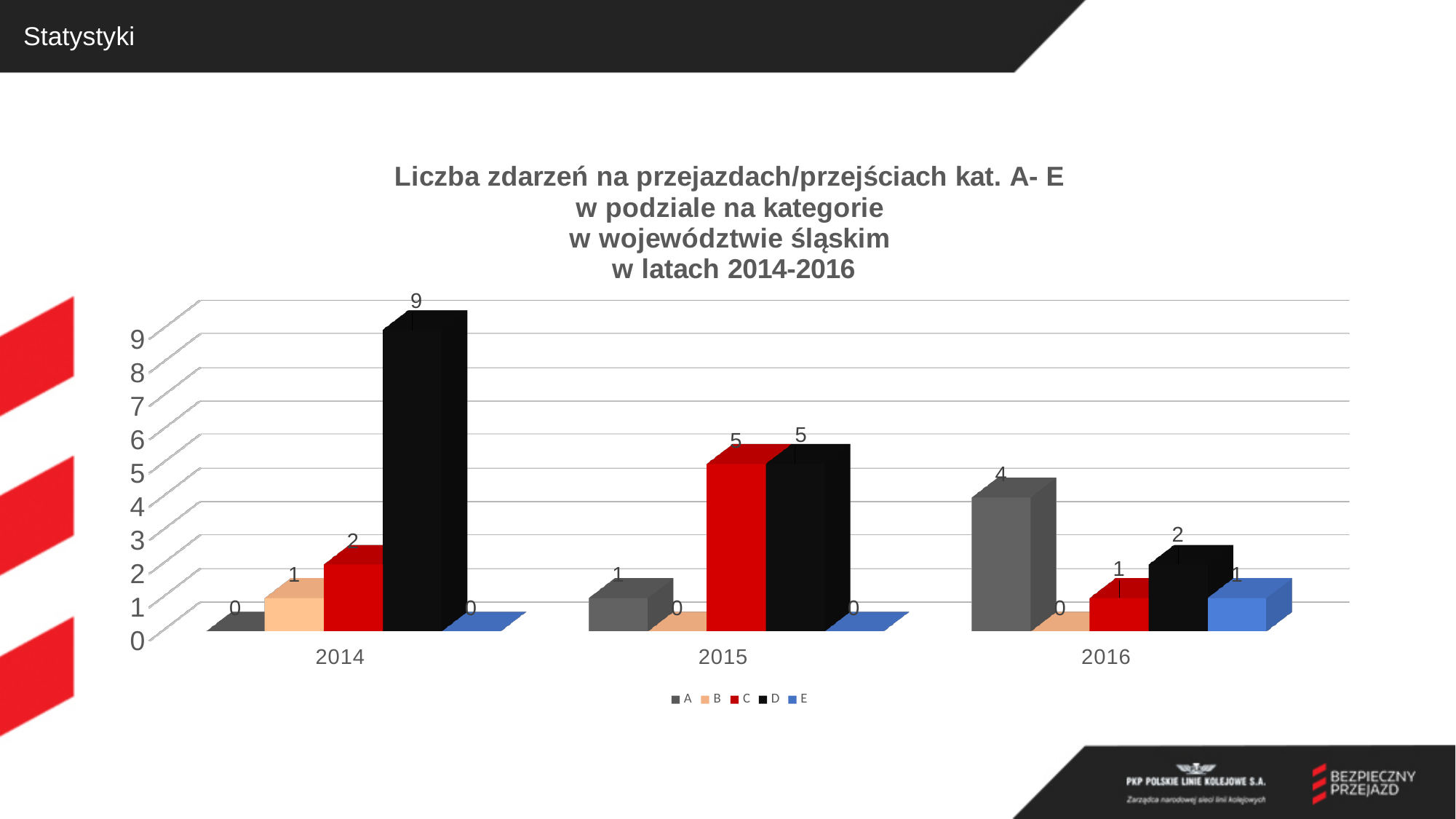
What is the value for series B in 2014? 1 Which is larger: the value for series C in 2016 or the value for series D in 2016? D in 2016 What kind of chart is shown on the slide? Bar chart How many years are shown on the x axis? 3 What is the value for series D in 2014? 9 How many series does the legend list? 5 Which series has the highest value in 2016? A What is the value for series E in 2016? 1 What is the value for series A in 2016? 4 What is the value for series C in 2015? 5 What is the difference between the value for series D in 2014 and the value for series D in 2015? 4 Which series has the highest value in 2014? D